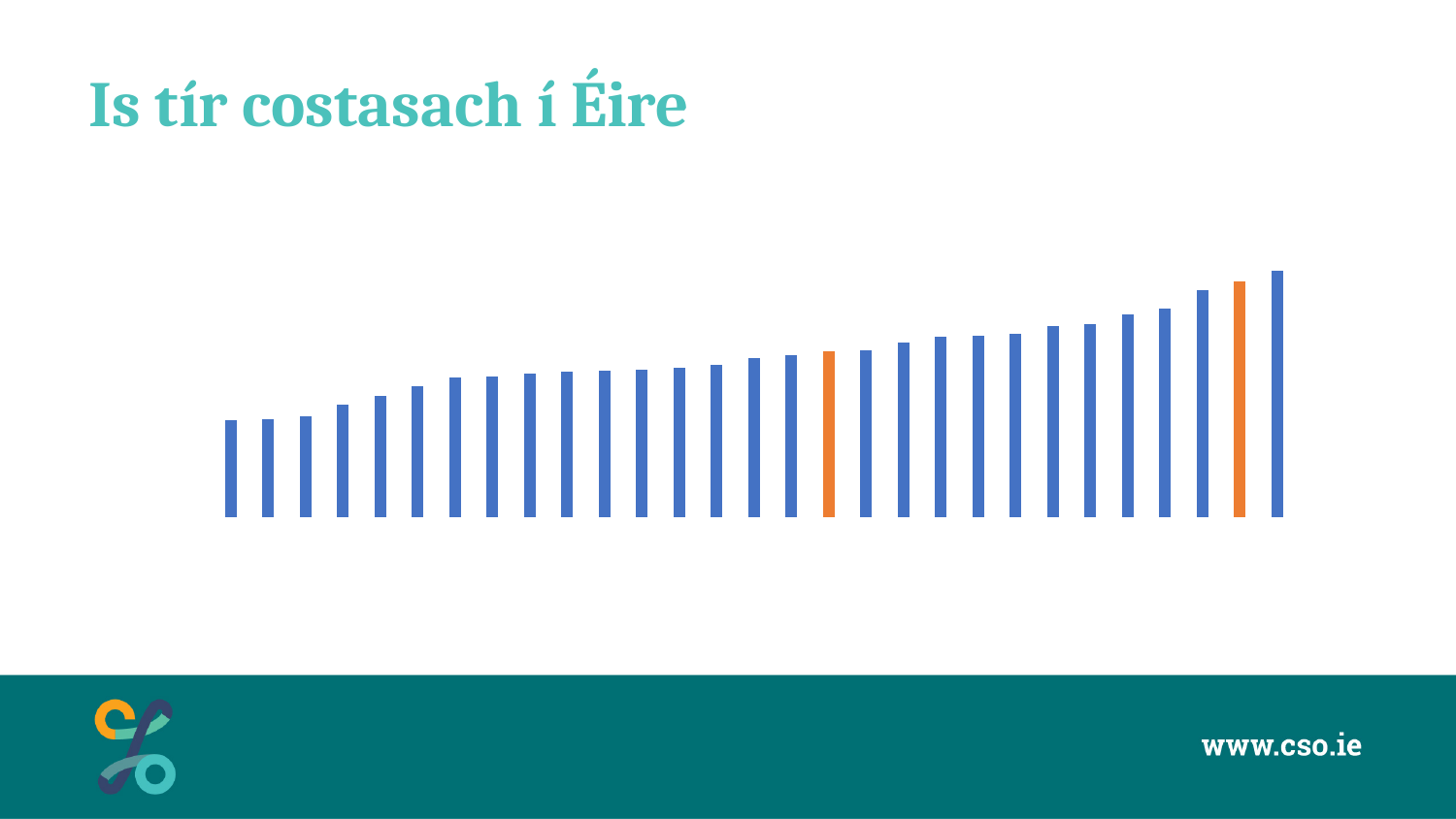
Do the bar heights rise or fall from left to right across the chart? rise How many bars are plotted in the chart? 29 What kind of chart is shown on the slide? bar chart How many bars in the chart are coloured orange rather than blue? 2 Which bar is the shortest in the chart: the leftmost or the rightmost? the leftmost What is the title of the slide containing the chart? Is tír costasach í Éire Which bar is the tallest in the chart: the leftmost or the rightmost? the rightmost Is the rightmost bar taller or shorter than the leftmost bar? taller